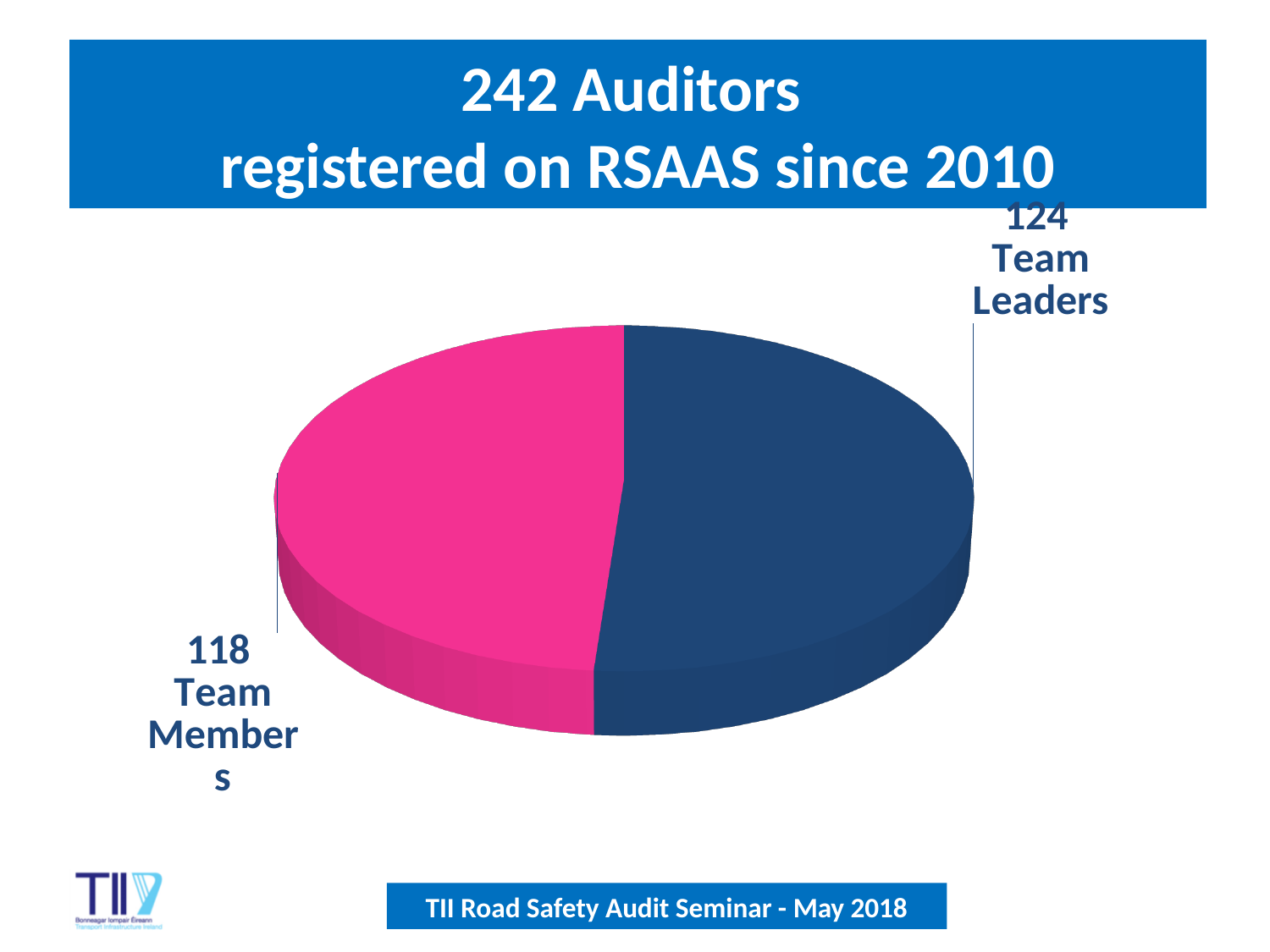
Which category has the largest slice in the pie chart? Team Leaders Which slice of the pie chart is larger, Team Leaders or Team Members? Team Leaders What kind of chart is shown on the slide? pie chart What colour is the Team Members slice of the pie chart? pink Which category has the smallest slice in the pie chart? Team Members What is the total number of auditors represented by the pie chart? 242 How many slices does the pie chart have? 2 How many Team Members are shown in the pie chart? 118 How many Team Leaders are shown in the pie chart? 124 What is the difference between the number of Team Leaders and the number of Team Members? 6 What colour is the Team Leaders slice of the pie chart? dark blue